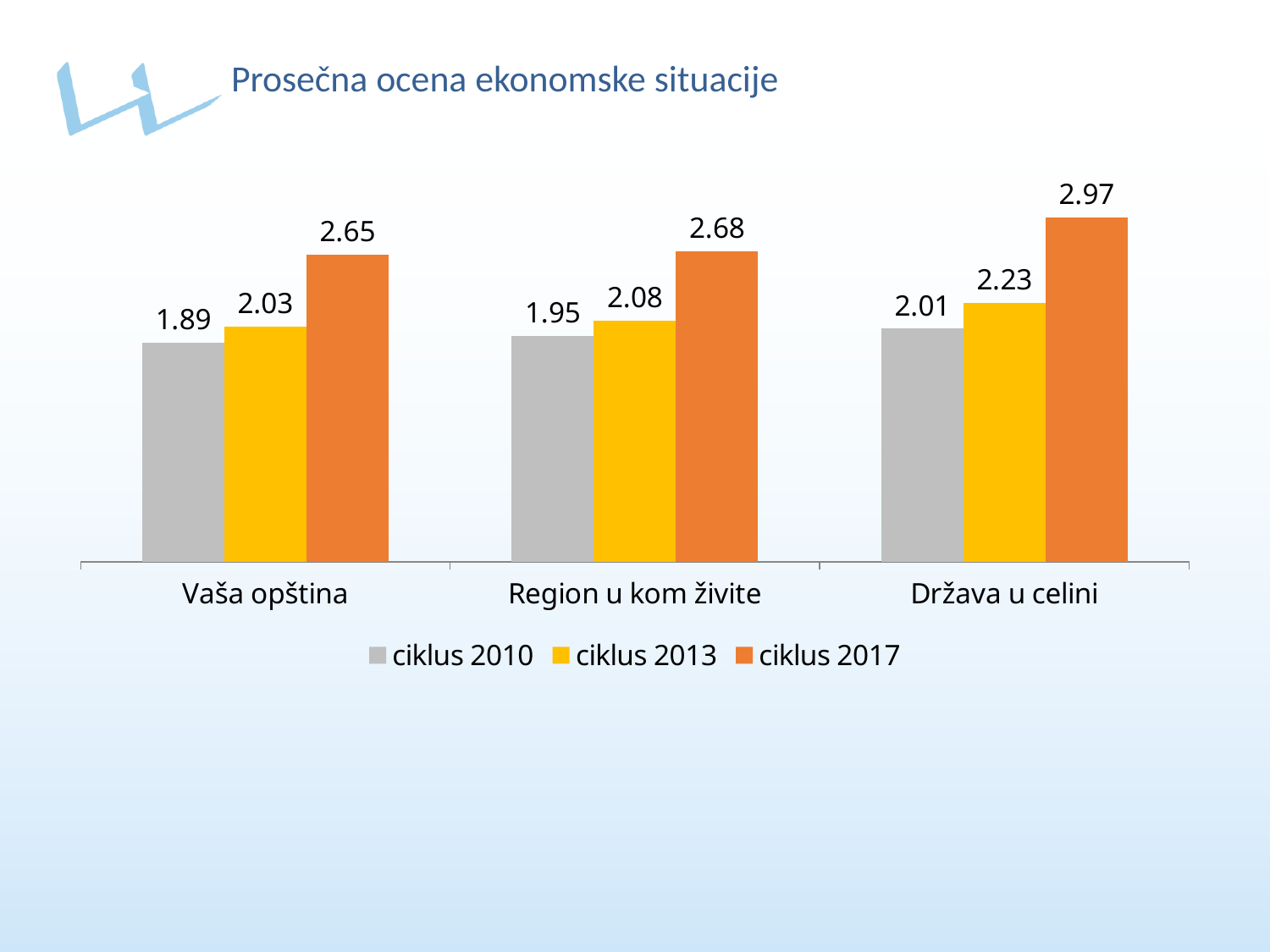
What is the value for ciklus 2010 in the Vaša opština category? 1.89 Which category has the lowest value for ciklus 2010? Vaša opština What is the title of the slide? Prosečna ocena ekonomske situacije How many categories are shown on the x axis? 3 Which is larger: the ciklus 2017 value for Vaša opština or the ciklus 2013 value for Država u celini? ciklus 2017 value for Vaša opština What kind of chart is shown on the slide? bar chart What is the value for ciklus 2017 in the Država u celini category? 2.97 How many series does the legend list? 3 What is the difference between the ciklus 2013 values for Država u celini and Vaša opština? 0.20 What is the value for ciklus 2013 in the Region u kom živite category? 2.08 Which category has the highest value for ciklus 2017? Država u celini What is the difference between the ciklus 2017 and ciklus 2010 values for Država u celini? 0.96